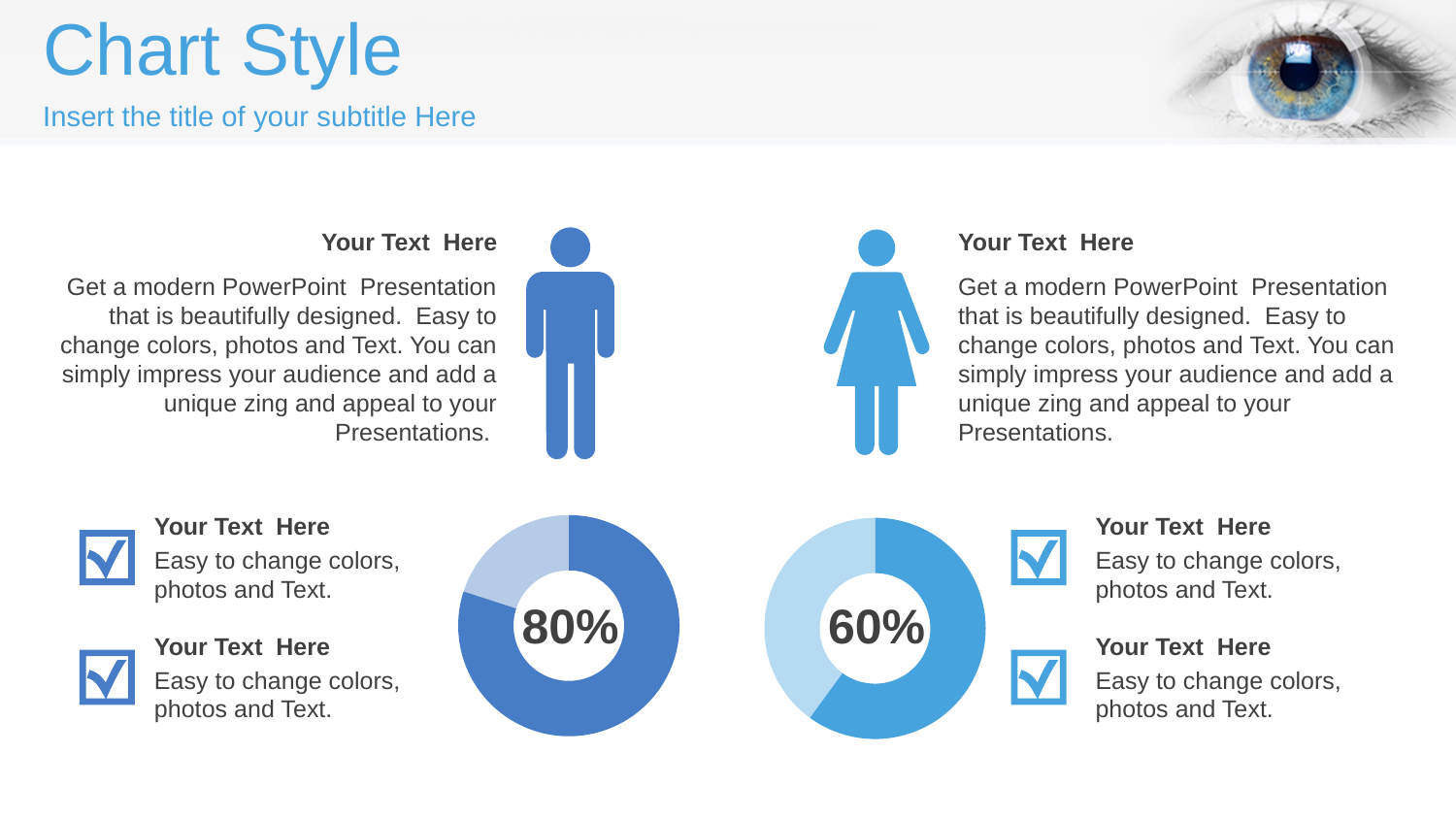
What kind of chart is used on the left side of the slide? Donut chart What percentage is shown in the center of the right donut chart? 60% How many donut charts are on the slide? 2 Is the value shown in the right donut chart greater or less than 50%? greater What percentage is shown in the center of the left donut chart? 80% What share of the left donut chart is taken by the lighter slice? 20% What kind of chart is used on the right side of the slide? Donut chart What is the difference between the percentage in the left donut chart and the percentage in the right donut chart? 20 percentage points Which donut chart shows the larger percentage, the left one or the right one? The left one (80%) How many slices does the left donut chart have? 2 Which icon appears above the left donut chart, a male or a female figure? Male figure What colour is the main slice of the right donut chart? Light blue